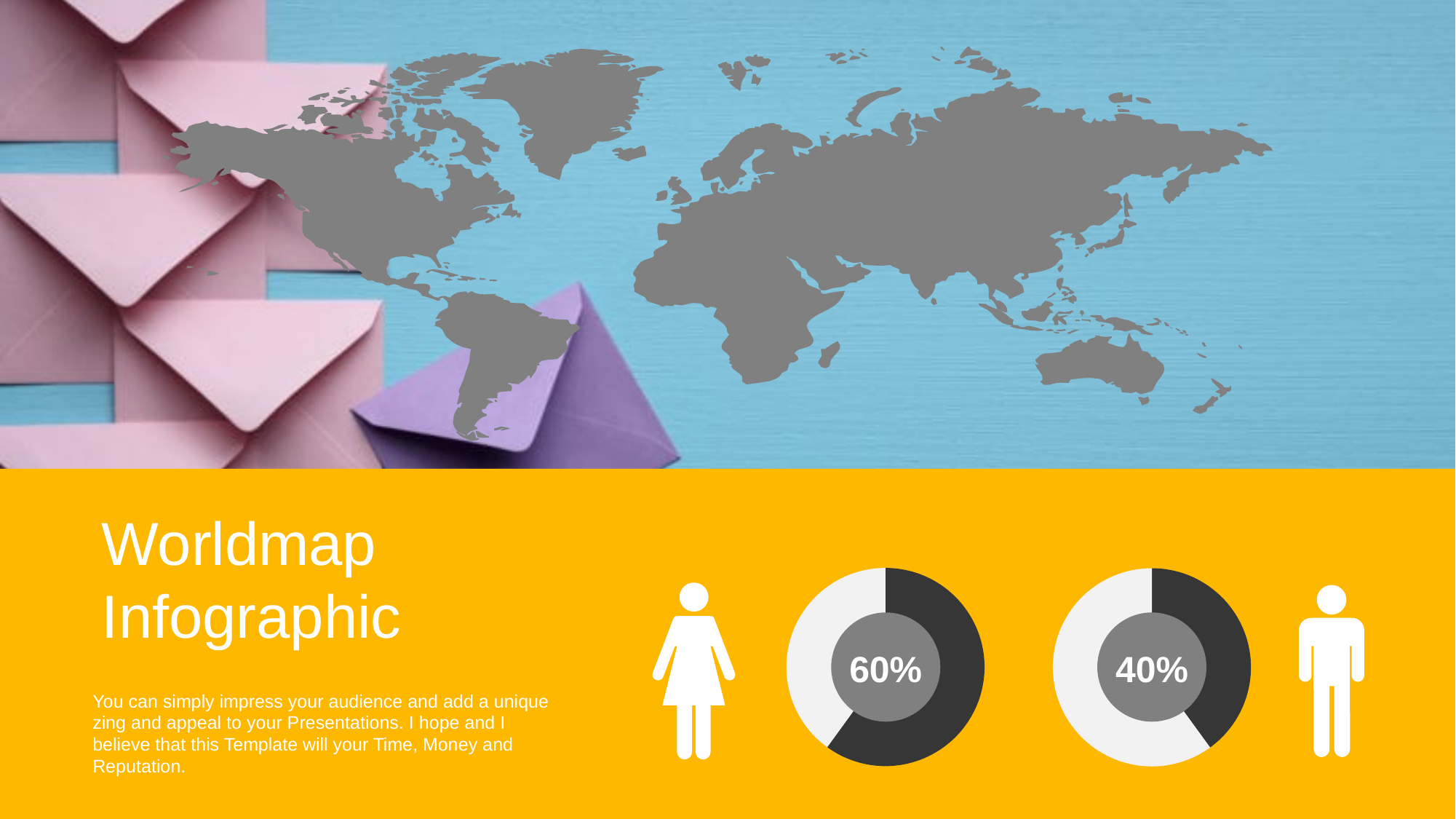
How many donut charts are shown on the slide? 2 What is the difference between the percentage in the left donut chart and the percentage in the right donut chart? 20% What kind of chart is used to display the 60% and 40% values? Donut chart Which of the two donut charts shows the larger percentage, the one beside the female figure or the one beside the male figure? The one beside the female figure Is the value in the right donut chart greater or less than 50%? less What is the total of the percentages shown in the two donut charts? 100% Is the value in the left donut chart greater or less than 50%? greater What value is shown in the centre of the left donut chart, next to the female figure? 60% What is the title of the slide containing the donut charts? Worldmap Infographic What colour is the filled portion of the donut charts? Dark grey What value is shown in the centre of the right donut chart, next to the male figure? 40%